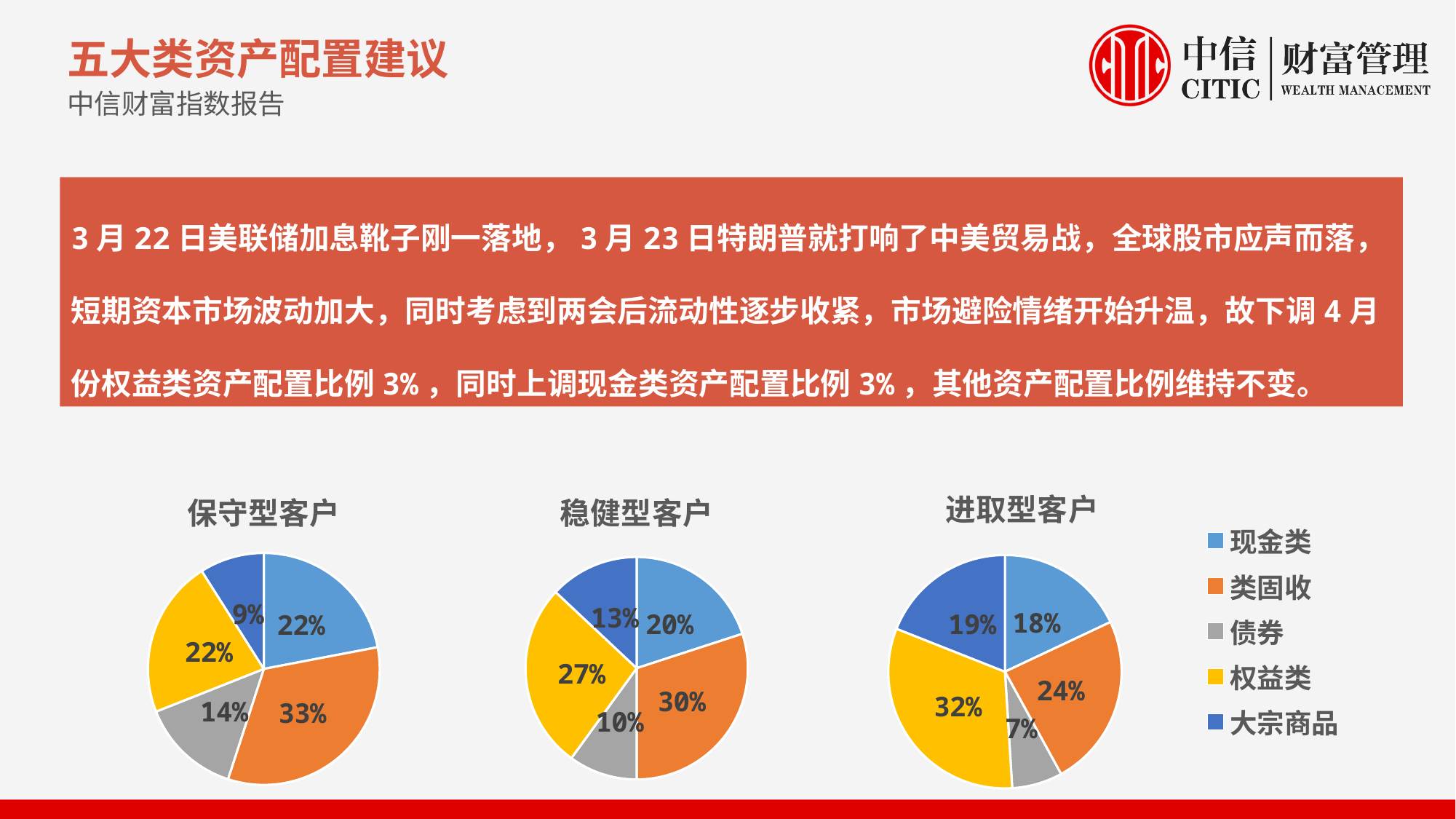
In the 保守型客户 pie chart, what is the difference between the 类固收 share and the 债券 share? 19% In the 稳健型客户 pie chart, which category has the largest share? 类固收 In the 进取型客户 pie chart, which is larger: the share of 现金类 or the share of 大宗商品? 大宗商品 In the 进取型客户 pie chart, what share does 债券 have? 7% In the 保守型客户 pie chart, what share does 类固收 have? 33% In the 进取型客户 pie chart, which category has the largest share? 权益类 In the 保守型客户 pie chart, which category has the smallest share? 大宗商品 What kind of chart is used for 保守型客户? Pie chart In the 稳健型客户 pie chart, what share does 权益类 have? 27% How many entries does the legend list? 5 Which colour represents 权益类 in the legend? Yellow How many slices does the 稳健型客户 pie chart have? 5